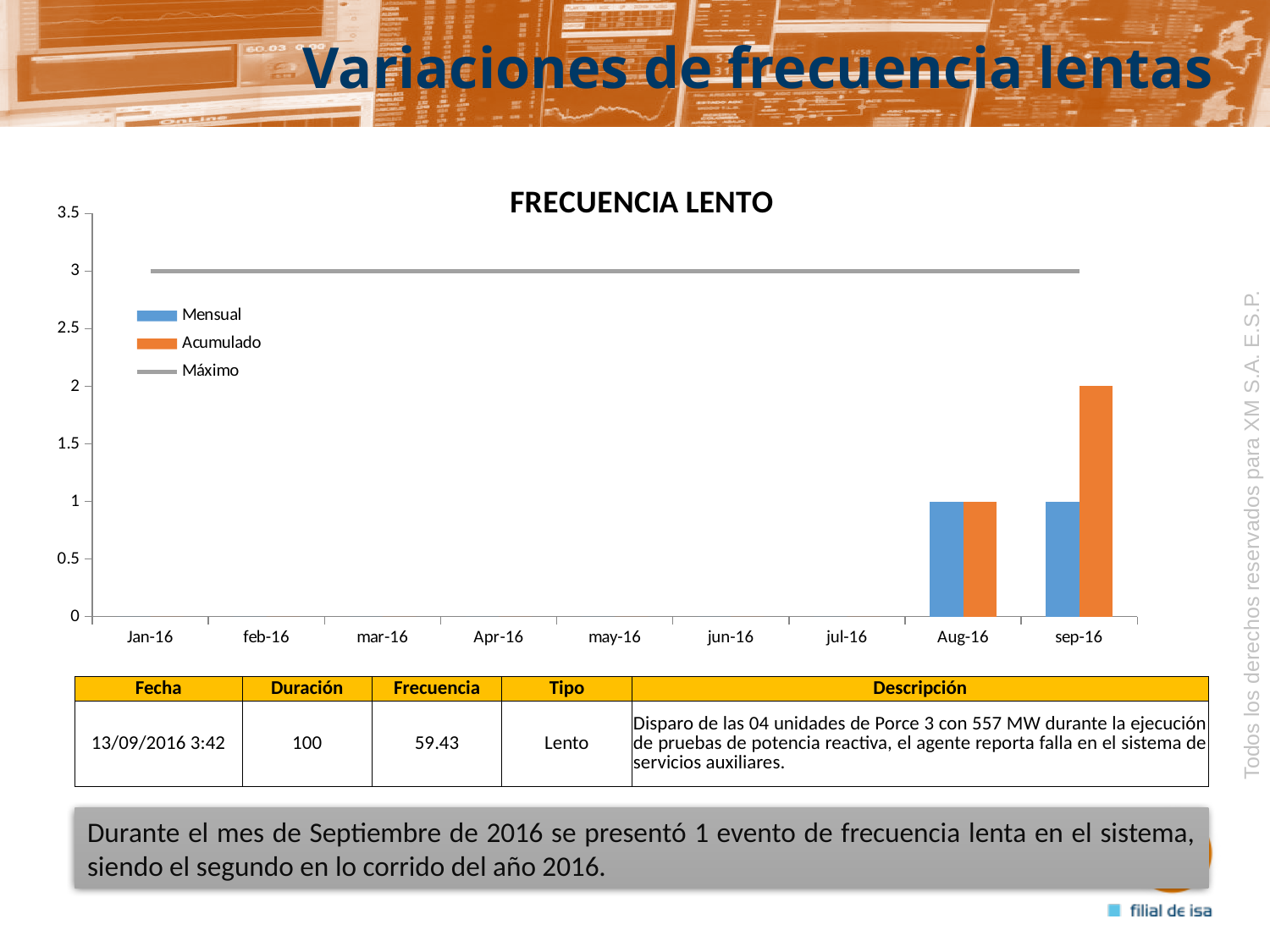
How many months are shown on the x axis of the chart? 9 At what level is the Máximo line drawn? 3 Which month has the highest Acumulado value? sep-16 What is the title of the chart? FRECUENCIA LENTO What kind of chart is shown on the slide? bar chart What is the Mensual value for Aug-16? 1 Is the Acumulado value for sep-16 greater or less than the Máximo line? less How many series does the chart legend list? 3 What is the Acumulado value for sep-16? 2 Which series is shown in orange in the chart? Acumulado What is the difference between the Acumulado values for sep-16 and Aug-16? 1 What is the Acumulado value for Aug-16? 1